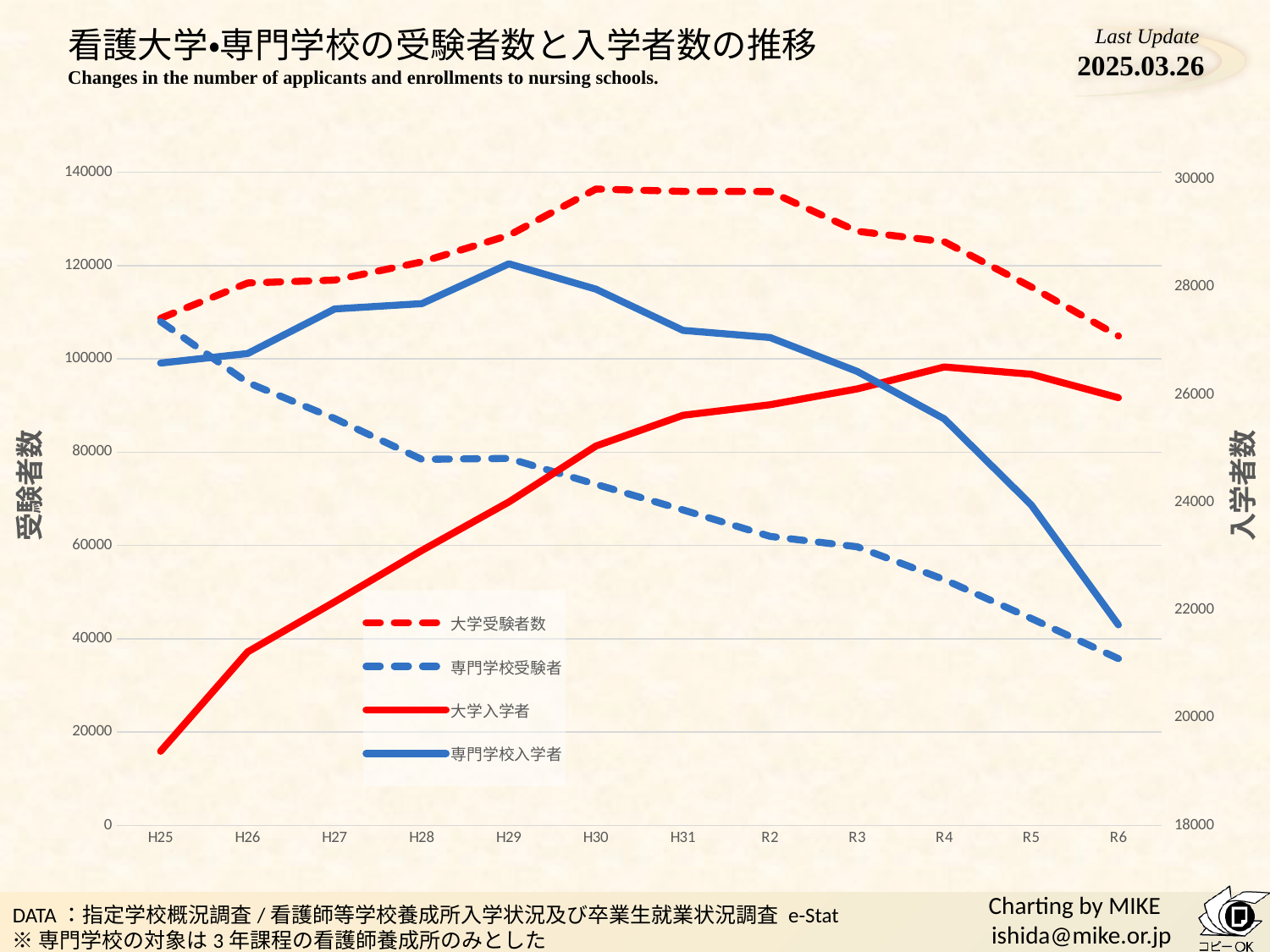
Is the value for 大学入学者 at H25 greater or less than 20000? less Does the 専門学校受験者 series rise or fall from H25 to R6? fall In which year is the 専門学校受験者 series highest? H25 Is the value for 大学受験者数 at R6 greater or less than 120000? less Is the value for 専門学校受験者 at R6 greater or less than 40000? less What kind of chart is shown on the slide? line chart What is the label of the right-hand vertical axis? 入学者数 How many series does the legend list? 4 At R6, which is larger: 大学受験者数 or 専門学校受験者? 大学受験者数 In which year is the 専門学校入学者 series highest? H29 How many year categories are shown on the x axis? 12 In which year is the 専門学校受験者 series lowest? R6